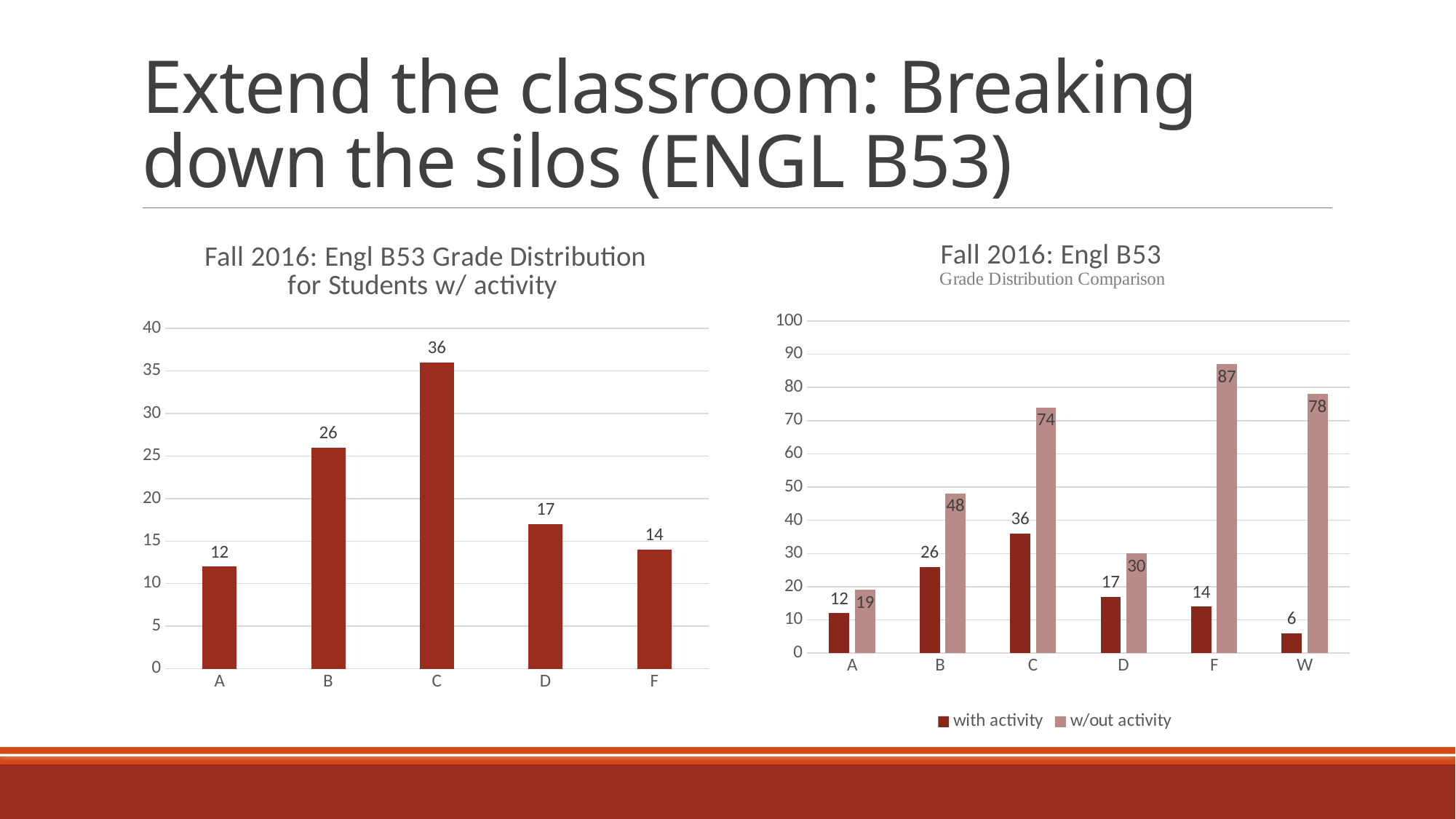
In the left chart 'Fall 2016: Engl B53 Grade Distribution for Students w/ activity', how many grade categories are shown? 5 What kind of chart is the left chart 'Fall 2016: Engl B53 Grade Distribution for Students w/ activity'? Bar chart In the right chart 'Fall 2016: Engl B53 Grade Distribution Comparison', how many grade categories are shown on the x axis? 6 In the right chart 'Fall 2016: Engl B53 Grade Distribution Comparison', what is the difference between the 'w/out activity' and 'with activity' values for grade C? 38 In the right chart 'Fall 2016: Engl B53 Grade Distribution Comparison', which grade has the highest value in the 'w/out activity' series? F In the right chart 'Fall 2016: Engl B53 Grade Distribution Comparison', what is the value for grade W in the 'with activity' series? 6 In the right chart 'Fall 2016: Engl B53 Grade Distribution Comparison', what is the value for grade F in the 'w/out activity' series? 87 In the right chart 'Fall 2016: Engl B53 Grade Distribution Comparison', how many series does the legend list? 2 In the right chart 'Fall 2016: Engl B53 Grade Distribution Comparison', which is larger for grade B: 'with activity' or 'w/out activity'? w/out activity In the left chart 'Fall 2016: Engl B53 Grade Distribution for Students w/ activity', what is the value for grade C? 36 In the left chart 'Fall 2016: Engl B53 Grade Distribution for Students w/ activity', which grade has the lowest value? A In the left chart 'Fall 2016: Engl B53 Grade Distribution for Students w/ activity', what is the difference between the values for B and D? 9